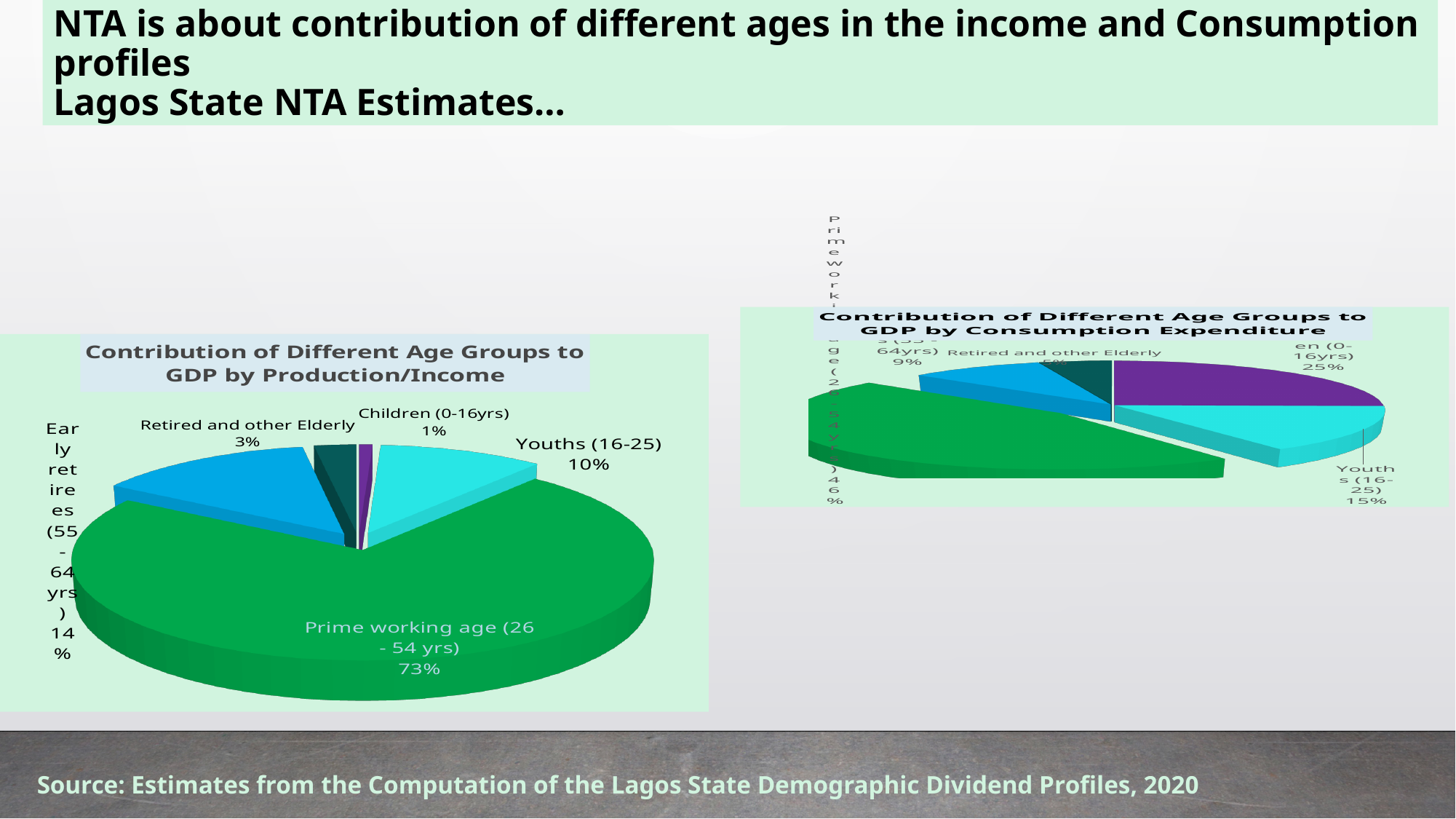
In the chart titled 'Contribution of Different Age Groups to GDP by Consumption Expenditure', which is larger: the share of Children (0-16yrs) or the share of Youths (16-25)? Children (0-16yrs) In the chart titled 'Contribution of Different Age Groups to GDP by Production/Income', what is the difference in percentage points between Early retirees (55-64 yrs) and Youths (16-25)? 4 percentage points In the chart titled 'Contribution of Different Age Groups to GDP by Production/Income', how many age groups are shown? 5 In the chart titled 'Contribution of Different Age Groups to GDP by Production/Income', which age group has the largest share? Prime working age (26 - 54 yrs) In the chart titled 'Contribution of Different Age Groups to GDP by Production/Income', what share do Children (0-16yrs) contribute? 1% In the chart titled 'Contribution of Different Age Groups to GDP by Consumption Expenditure', what share does Prime working age (26-54 yrs) contribute? 46% In the chart titled 'Contribution of Different Age Groups to GDP by Consumption Expenditure', what share do Youths (16-25) contribute? 15% In the chart titled 'Contribution of Different Age Groups to GDP by Production/Income', what share do Retired and other Elderly contribute? 3% In the chart titled 'Contribution of Different Age Groups to GDP by Production/Income', what share does Prime working age (26 - 54 yrs) contribute? 73% In the chart titled 'Contribution of Different Age Groups to GDP by Production/Income', which age group has the smallest share? Children (0-16yrs) In the chart titled 'Contribution of Different Age Groups to GDP by Production/Income', what share do Youths (16-25) contribute? 10% What type of chart is the chart titled 'Contribution of Different Age Groups to GDP by Production/Income'? Pie chart